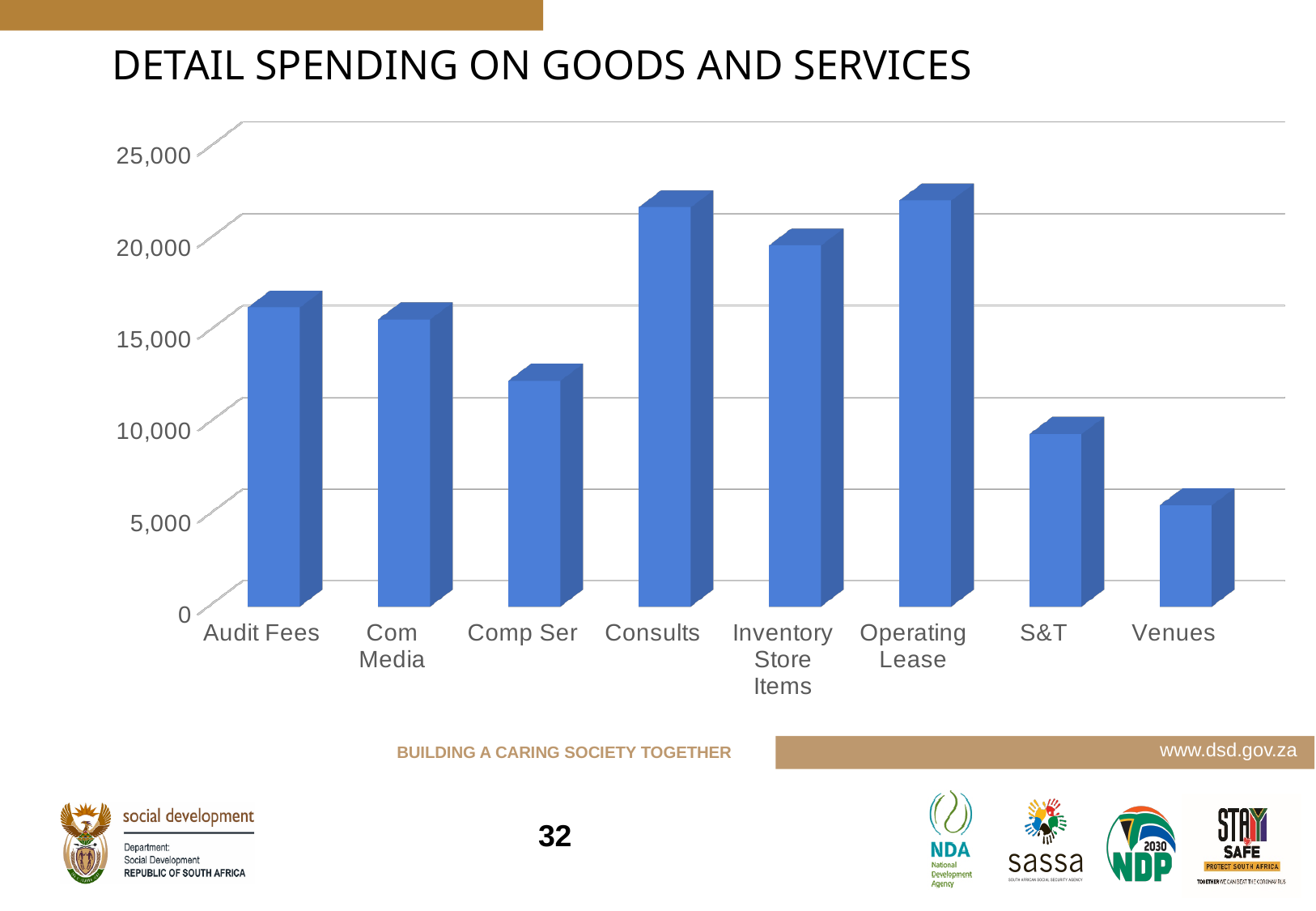
Which category has the lowest value in the chart? Venues Which is larger, the value for S&T or the value for Venues? S&T What kind of chart is shown on the slide? bar chart Is the value for Consults greater or less than 20,000? greater Which is larger, the value for Consults or the value for Inventory Store Items? Consults Is the value for Audit Fees greater or less than 15,000? greater Is the value for Operating Lease greater or less than 25,000? less How many categories are shown on the x axis of the chart? 8 What is the title of the chart? DETAIL SPENDING ON GOODS AND SERVICES